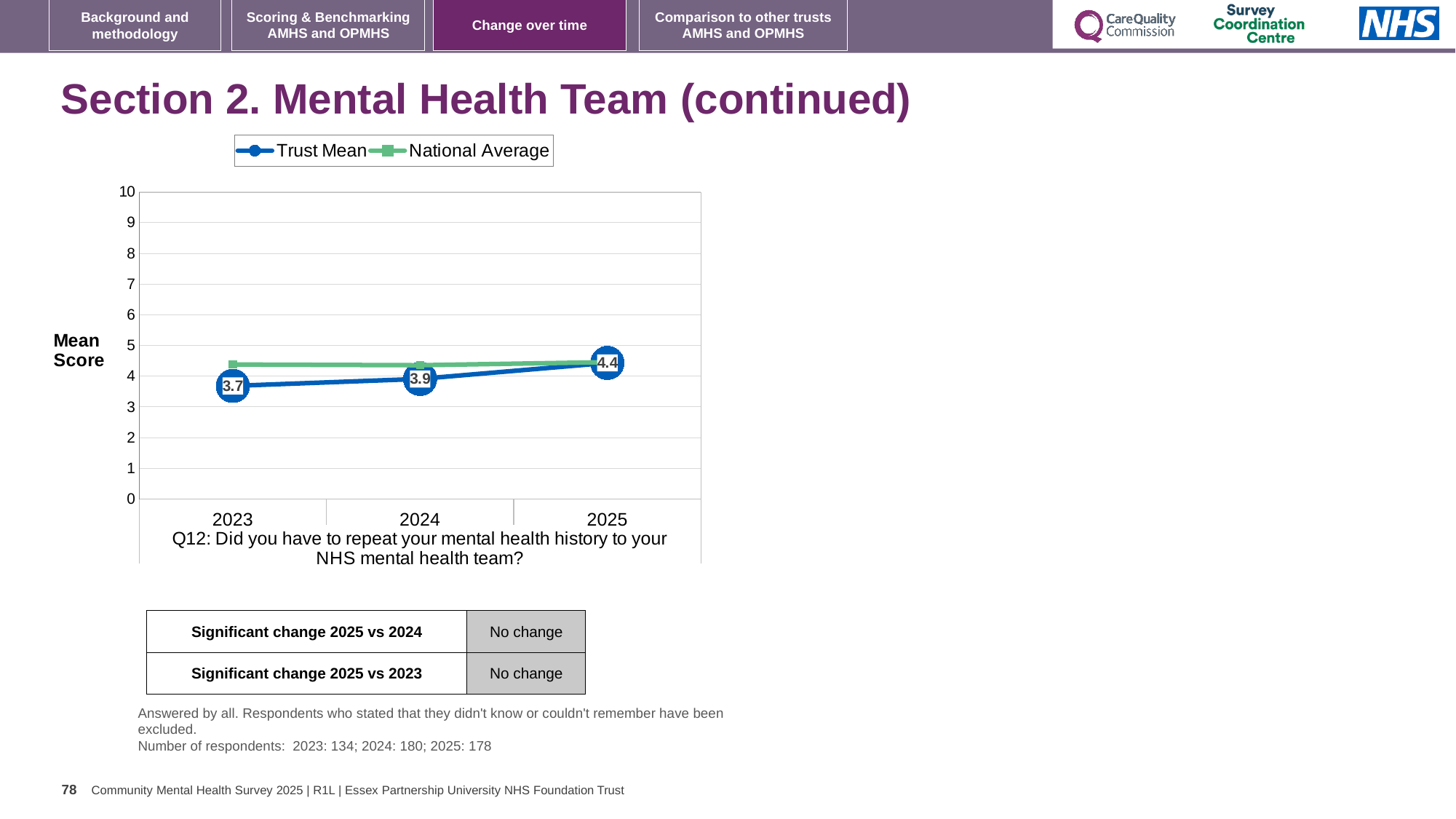
What is the Trust Mean score for 2023? 3.7 In which year is the Trust Mean score lowest? 2023 What is the Trust Mean score for 2025? 4.4 How many years are shown on the x axis? 3 What is the difference between the Trust Mean score in 2025 and in 2023? 0.7 In 2023, which is larger: the Trust Mean or the National Average? National Average In which year is the Trust Mean score highest? 2025 Is the National Average value for 2023 greater or less than 4? greater What kind of chart is shown on the slide? Line chart How many series does the legend list? 2 Does the Trust Mean rise or fall from 2023 to 2025? Rise What is the Trust Mean score for 2024? 3.9